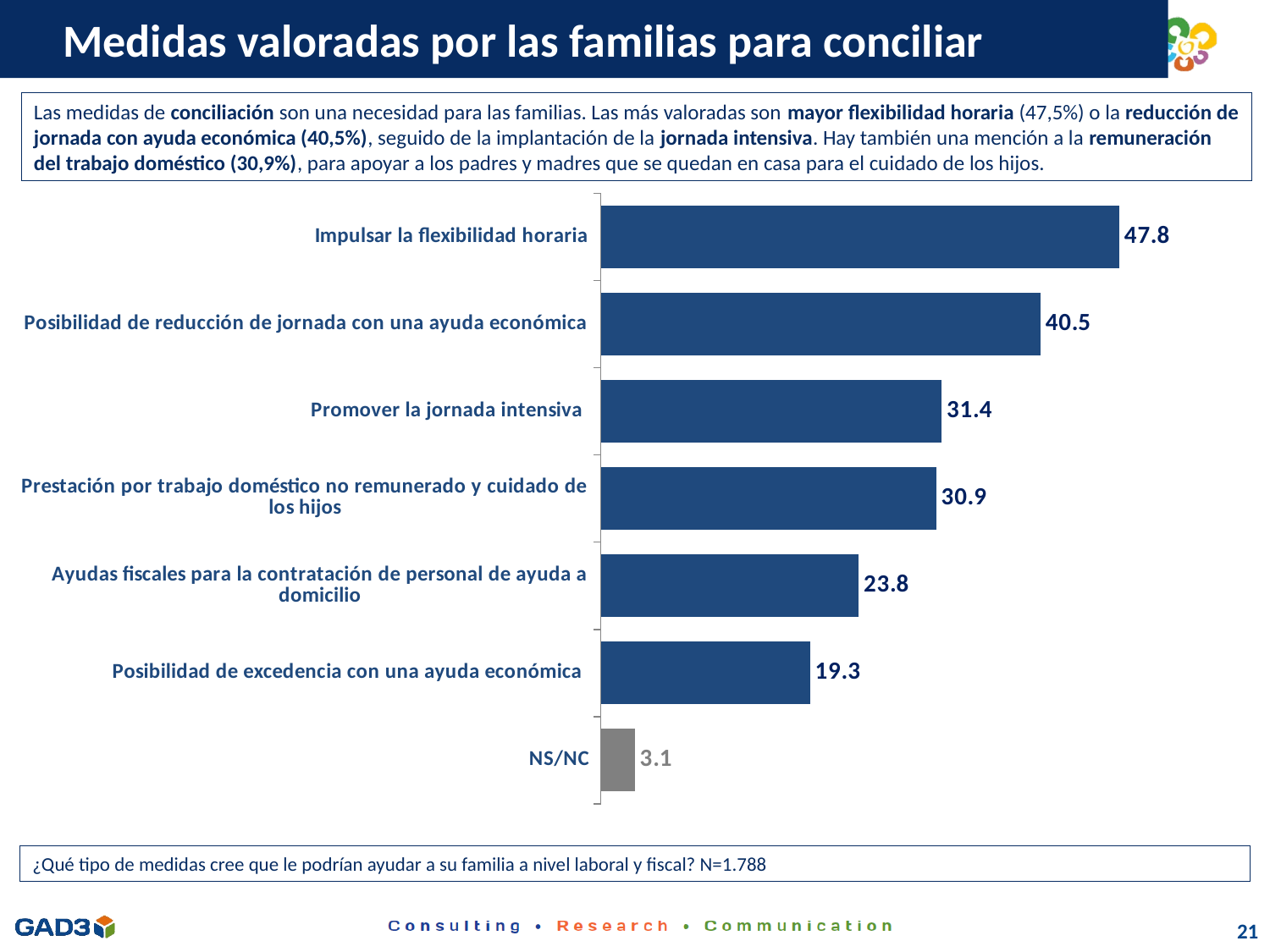
What kind of chart is shown on the slide? Bar chart What is the value for "Impulsar la flexibilidad horaria"? 47.8 What is the difference between the values for "Impulsar la flexibilidad horaria" and "Posibilidad de reducción de jornada con una ayuda económica"? 7.3 What colour is the bar for "NS/NC"? Grey What is the difference between the values for "Ayudas fiscales para la contratación de personal de ayuda a domicilio" and "Posibilidad de excedencia con una ayuda económica"? 4.5 How many categories are shown in the chart? 7 Which category has the lowest value? NS/NC What is the value for "Promover la jornada intensiva"? 31.4 Which is larger: the value for "Promover la jornada intensiva" or the value for "Ayudas fiscales para la contratación de personal de ayuda a domicilio"? Promover la jornada intensiva What is the value for "Posibilidad de excedencia con una ayuda económica"? 19.3 Which category has the highest value? Impulsar la flexibilidad horaria What is the value for "NS/NC"? 3.1